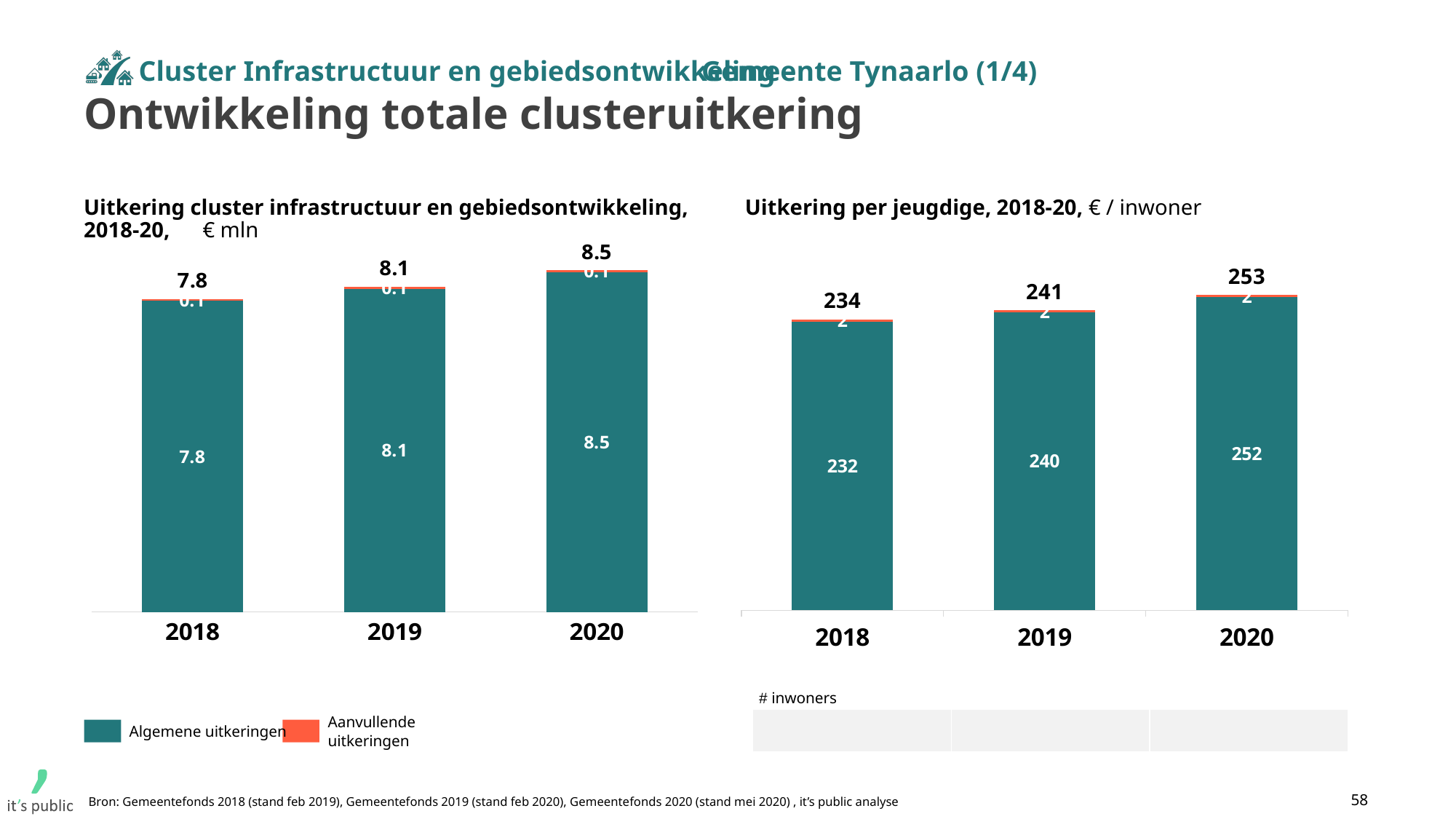
In the right chart (Uitkering per jeugdige), which year has the lowest total? 2018 In the right chart (Uitkering per jeugdige), how many years are shown on the x axis? 3 In the right chart (Uitkering per jeugdige), what is the Aanvullende uitkeringen value for 2020? 2 In the left chart (Uitkering cluster infrastructuur en gebiedsontwikkeling), what is the Aanvullende uitkeringen value for 2019? 0.1 In the left chart (Uitkering cluster infrastructuur en gebiedsontwikkeling), what is the Algemene uitkeringen value for 2020? 8.5 In the right chart (Uitkering per jeugdige), what is the total value shown above the bar for 2019? 241 In the left chart (Uitkering cluster infrastructuur en gebiedsontwikkeling), how many series does the legend list? 2 In the left chart (Uitkering cluster infrastructuur en gebiedsontwikkeling), do the totals rise or fall from 2018 to 2020? rise In the left chart (Uitkering cluster infrastructuur en gebiedsontwikkeling), which year has the highest total? 2020 What kind of chart is the right chart (Uitkering per jeugdige)? stacked bar chart In the left chart (Uitkering cluster infrastructuur en gebiedsontwikkeling), what is the total value shown above the bar for 2018? 7.8 In the right chart (Uitkering per jeugdige), what is the Algemene uitkeringen value for 2018? 232